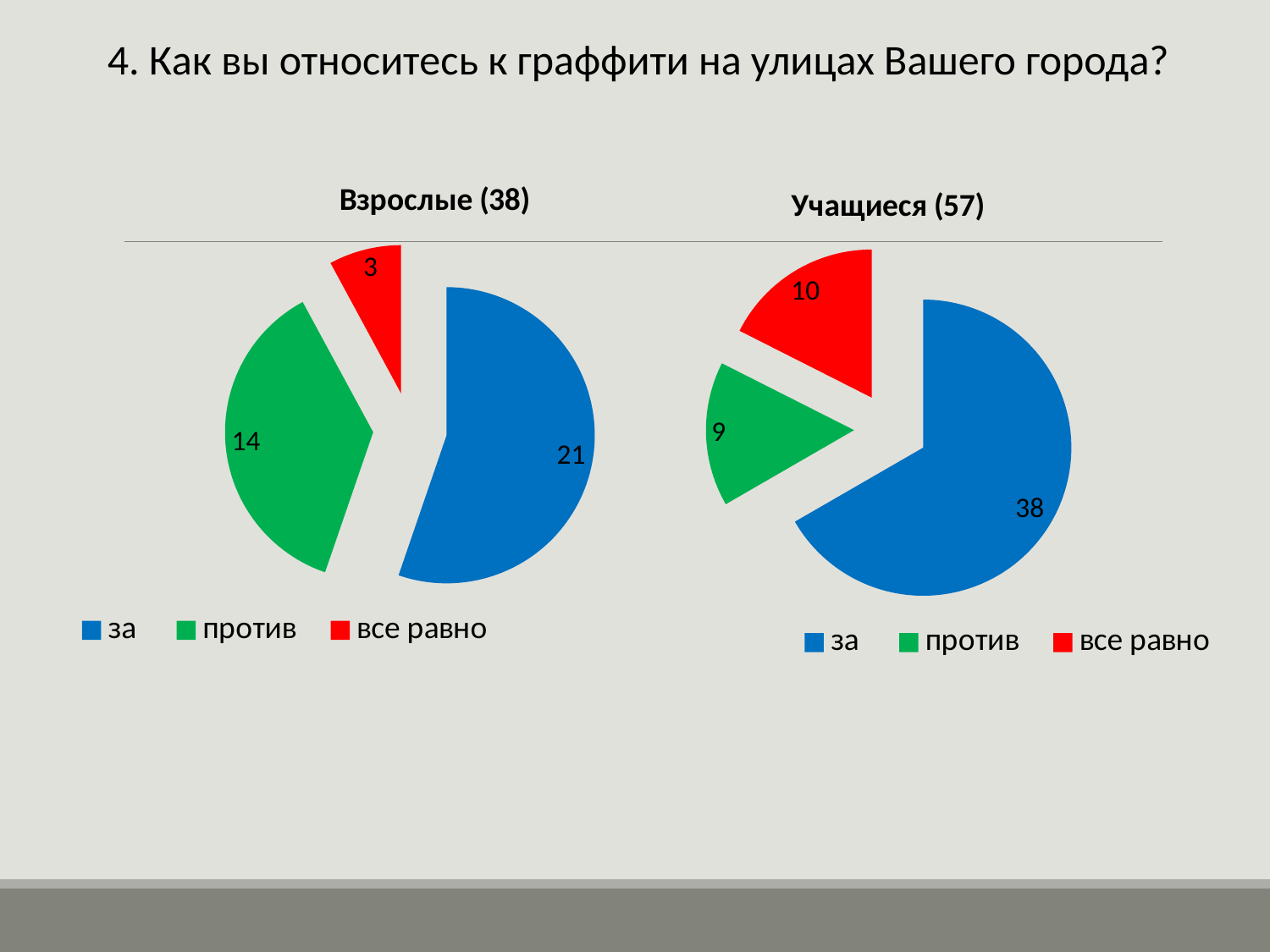
In the "Учащиеся (57)" chart, what is the value for "против"? 9 In the "Взрослые (38)" chart, which category has the smallest slice? все равно In the "Взрослые (38)" chart, what is the difference between the values for "за" and "против"? 7 In the "Учащиеся (57)" chart, what is the value for "все равно"? 10 How many slices does the "Взрослые (38)" chart have? 3 In the "Учащиеся (57)" chart, which is larger: "против" or "все равно"? все равно In the "Учащиеся (57)" chart, which category has the largest slice? за In the "Учащиеся (57)" chart, what is the total of all slices? 57 In the "Взрослые (38)" chart, what is the value for "за"? 21 How many entries does the legend of the "Взрослые (38)" chart list? 3 What kind of chart is the "Учащиеся (57)" chart? pie chart In the "Взрослые (38)" chart, what colour is the "против" slice? green